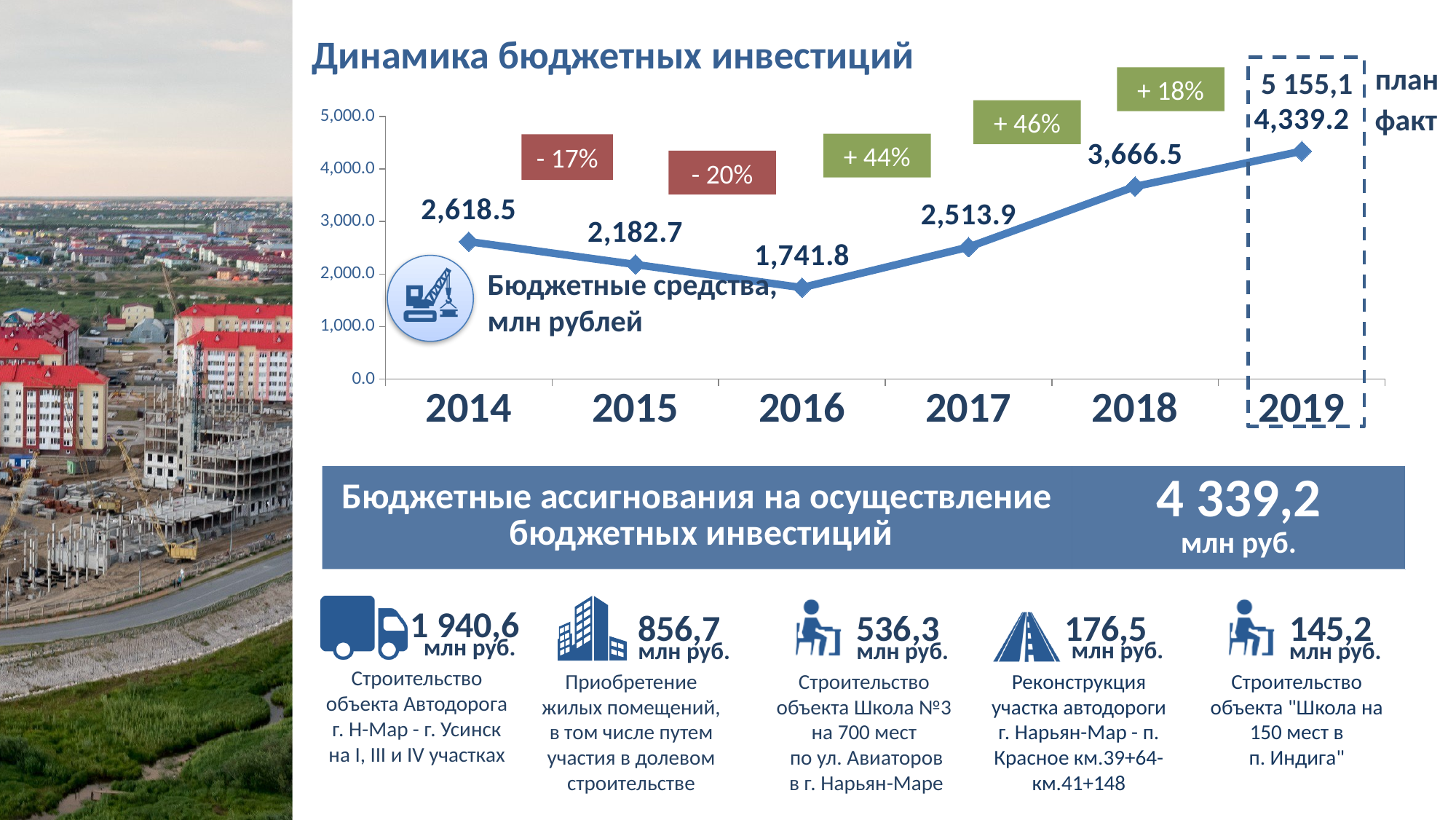
What is the value plotted for 2016 in the "Динамика бюджетных инвестиций" chart? 1,741.8 What percentage change is labelled between 2016 and 2017 in the "Динамика бюджетных инвестиций" chart? + 44% Which year has the highest plotted value in the "Динамика бюджетных инвестиций" chart? 2019 What is the value plotted for 2014 in the "Динамика бюджетных инвестиций" chart? 2,618.5 What is the difference between the 2018 and 2017 values in the "Динамика бюджетных инвестиций" chart? 1,152.6 What is the planned (план) value shown for 2019 in the "Динамика бюджетных инвестиций" chart? 5 155,1 Which year has the lowest plotted value in the "Динамика бюджетных инвестиций" chart? 2016 Which is larger in the "Динамика бюджетных инвестиций" chart, the value for 2014 or the value for 2017? 2014 Do the values in the "Динамика бюджетных инвестиций" chart rise or fall from 2016 to 2019? rise What is the actual (факт) value shown for 2019 in the "Динамика бюджетных инвестиций" chart? 4,339.2 What type of chart is shown under the title "Динамика бюджетных инвестиций"? line chart How many years are plotted on the x axis of the "Динамика бюджетных инвестиций" chart? 6